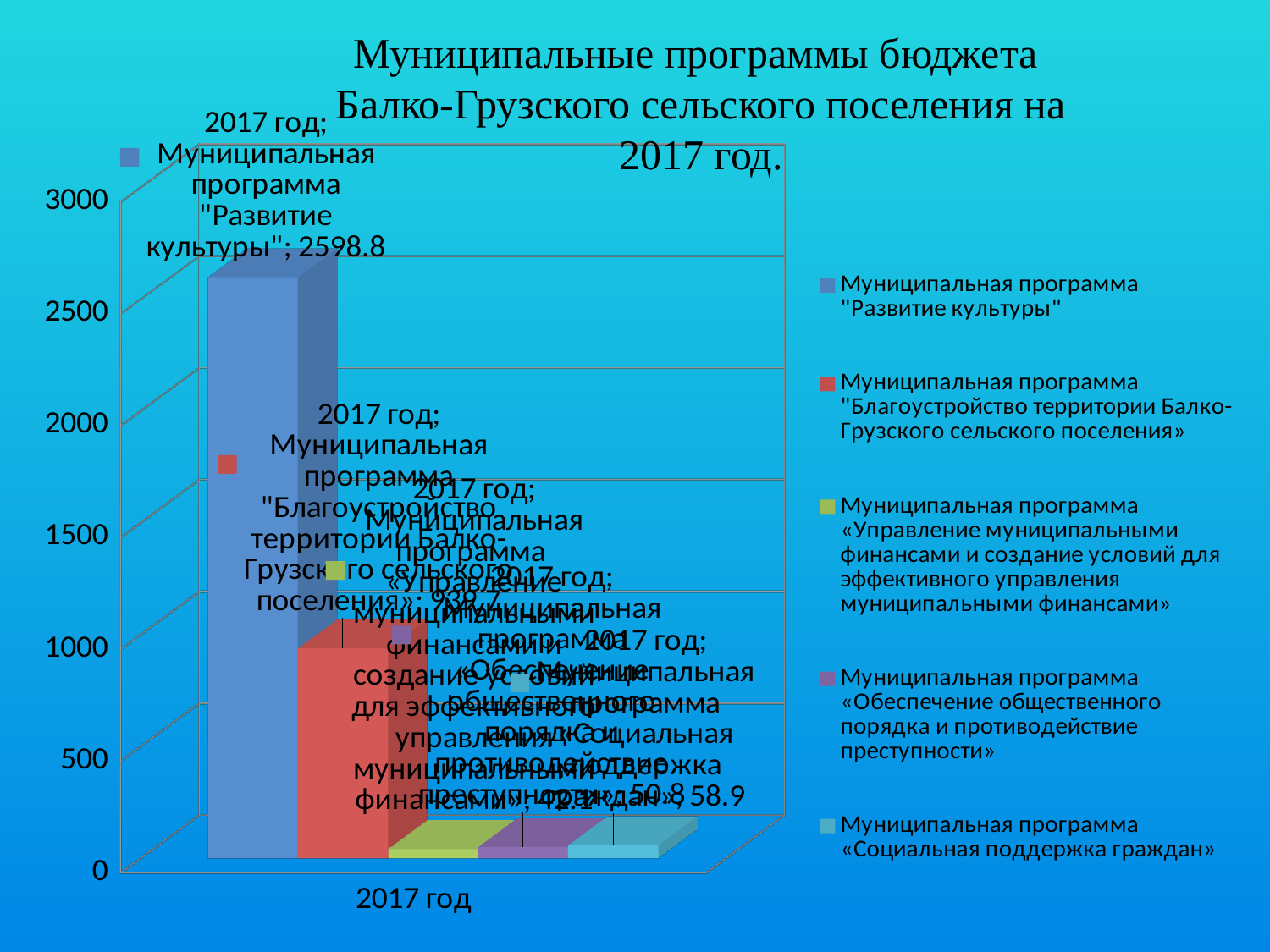
Is the value for "Развитие культуры" greater or less than 2500? greater How many categories are shown on the x axis? 1 How many series does the legend list? 5 Is the value for "Благоустройство территории Балко-Грузского сельского поселения" greater or less than 1000? less What is the title of the chart? Муниципальные программы бюджета Балко-Грузского сельского поселения на 2017 год. What is the difference between the values for "Развитие культуры" and "Благоустройство территории Балко-Грузского сельского поселения"? 1659.1 What is the value for the series Муниципальная программа "Благоустройство территории Балко-Грузского сельского поселения"? 939.7 Which is larger: the value for "Развитие культуры" or the value for "Благоустройство территории Балко-Грузского сельского поселения"? Развитие культуры What type of chart is shown on the slide? bar chart Which series has the highest value? Муниципальная программа "Развитие культуры" What is the value for the series Муниципальная программа "Развитие культуры"? 2598.8 What is the category label on the x axis? 2017 год